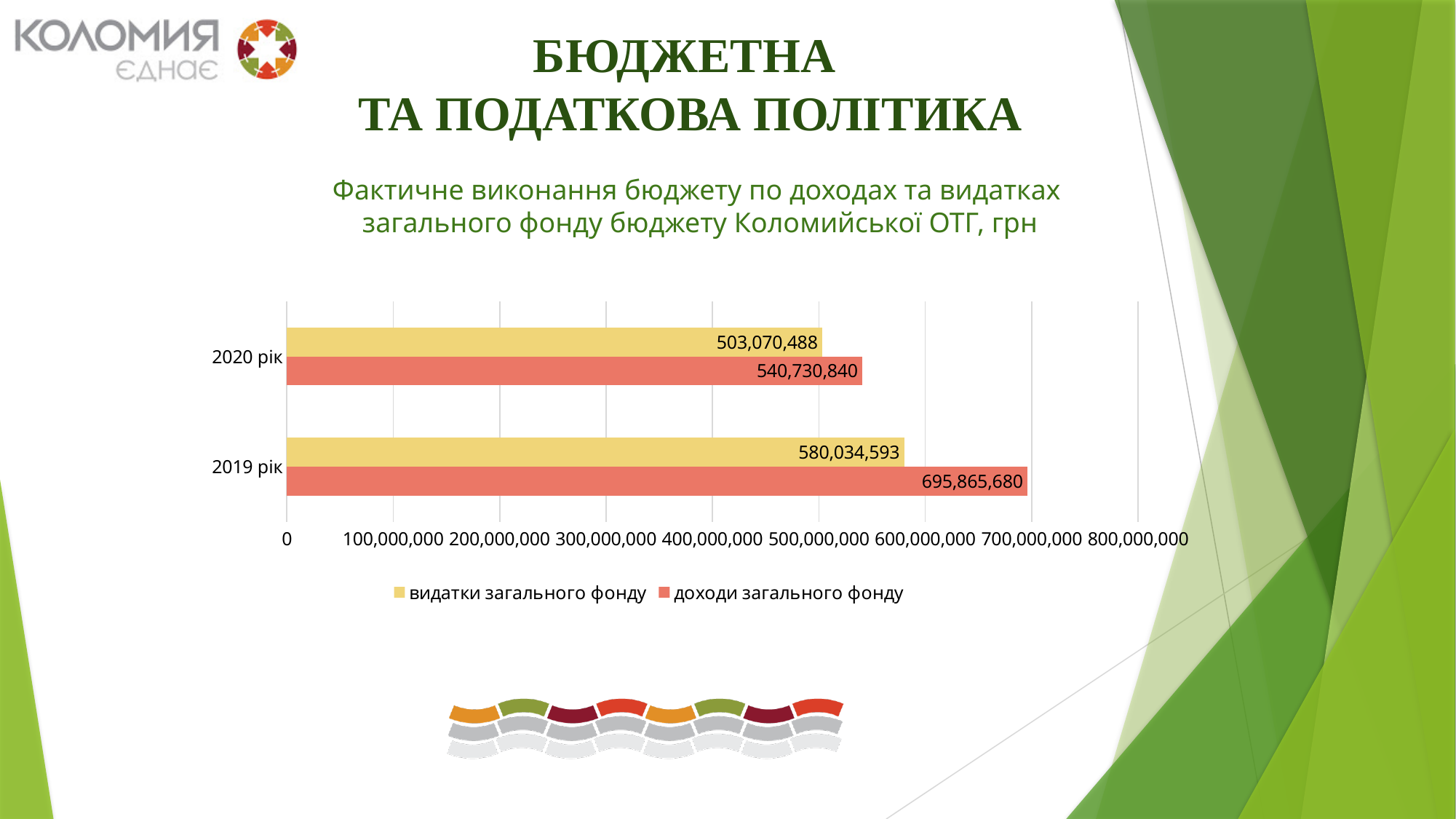
What is the value of доходи загального фонду for 2019 рік? 695,865,680 What is the value of видатки загального фонду for 2020 рік? 503,070,488 Which year has the lower value of видатки загального фонду? 2020 рік By how much did доходи загального фонду decrease from 2019 рік to 2020 рік? 155,134,840 What type of chart is shown on the slide? bar chart Which year has the higher value of доходи загального фонду? 2019 рік For 2020 рік, which is larger: видатки загального фонду or доходи загального фонду? доходи загального фонду What is the difference between доходи загального фонду and видатки загального фонду for 2019 рік? 115,831,087 How many series does the legend list? 2 What is the value of видатки загального фонду for 2019 рік? 580,034,593 How many years are shown on the chart? 2 What is the value of доходи загального фонду for 2020 рік? 540,730,840